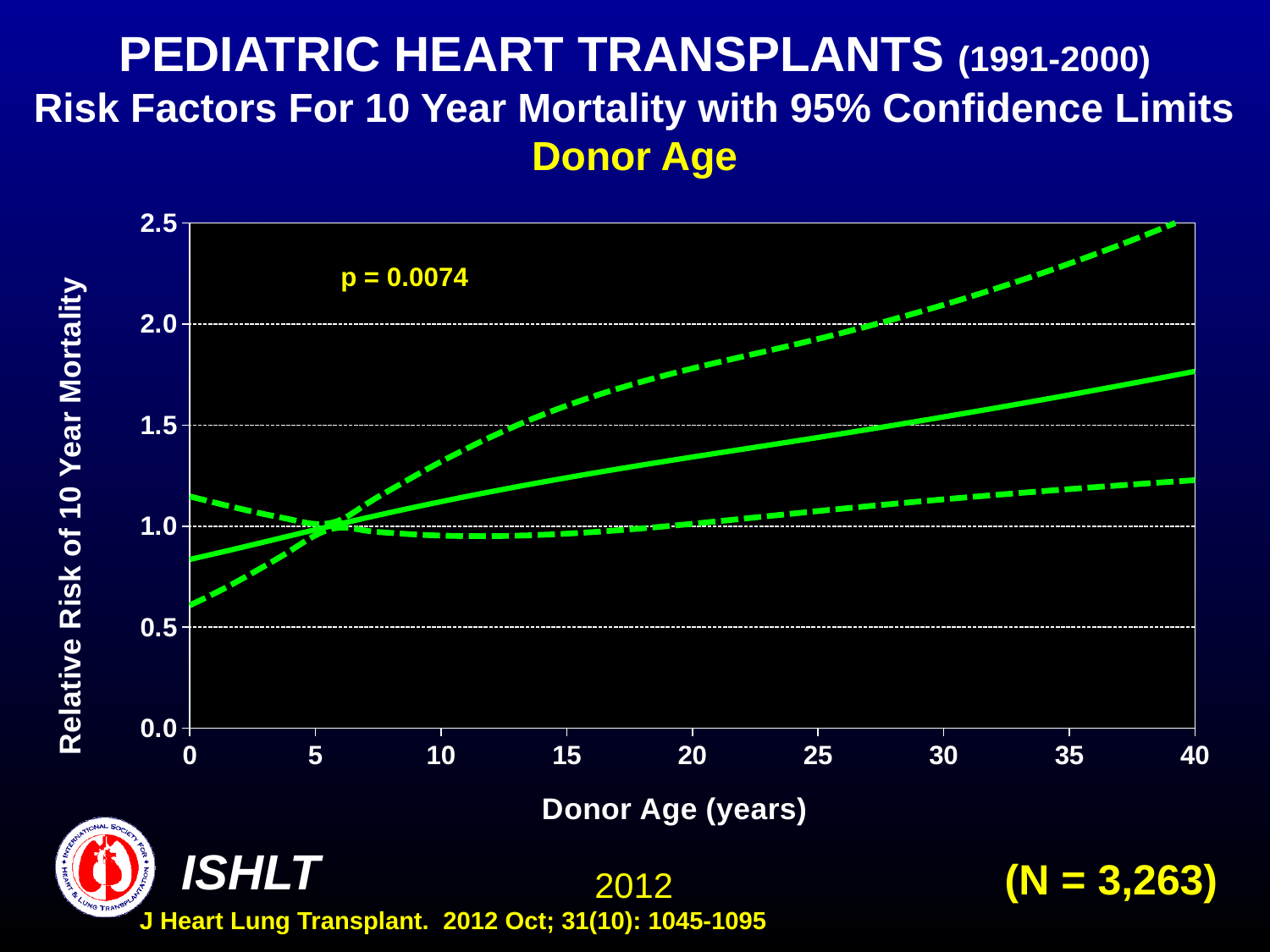
Is the lower dashed confidence limit at a donor age of 40 years greater or less than 1.0? greater Does the solid line for relative risk of 10 year mortality rise or fall as donor age increases? rise How many lines are plotted on the chart? 3 Is the value of the solid relative risk line at a donor age of 40 years greater or less than 1.5? greater What kind of chart is shown on the slide? line chart Is the solid relative risk line higher at a donor age of 40 years or at a donor age of 0 years? 40 years What is the label of the x axis? Donor Age (years) What p-value is printed on the chart? p = 0.0074 Is the upper dashed confidence limit at a donor age of 0 years greater or less than 0.5? greater